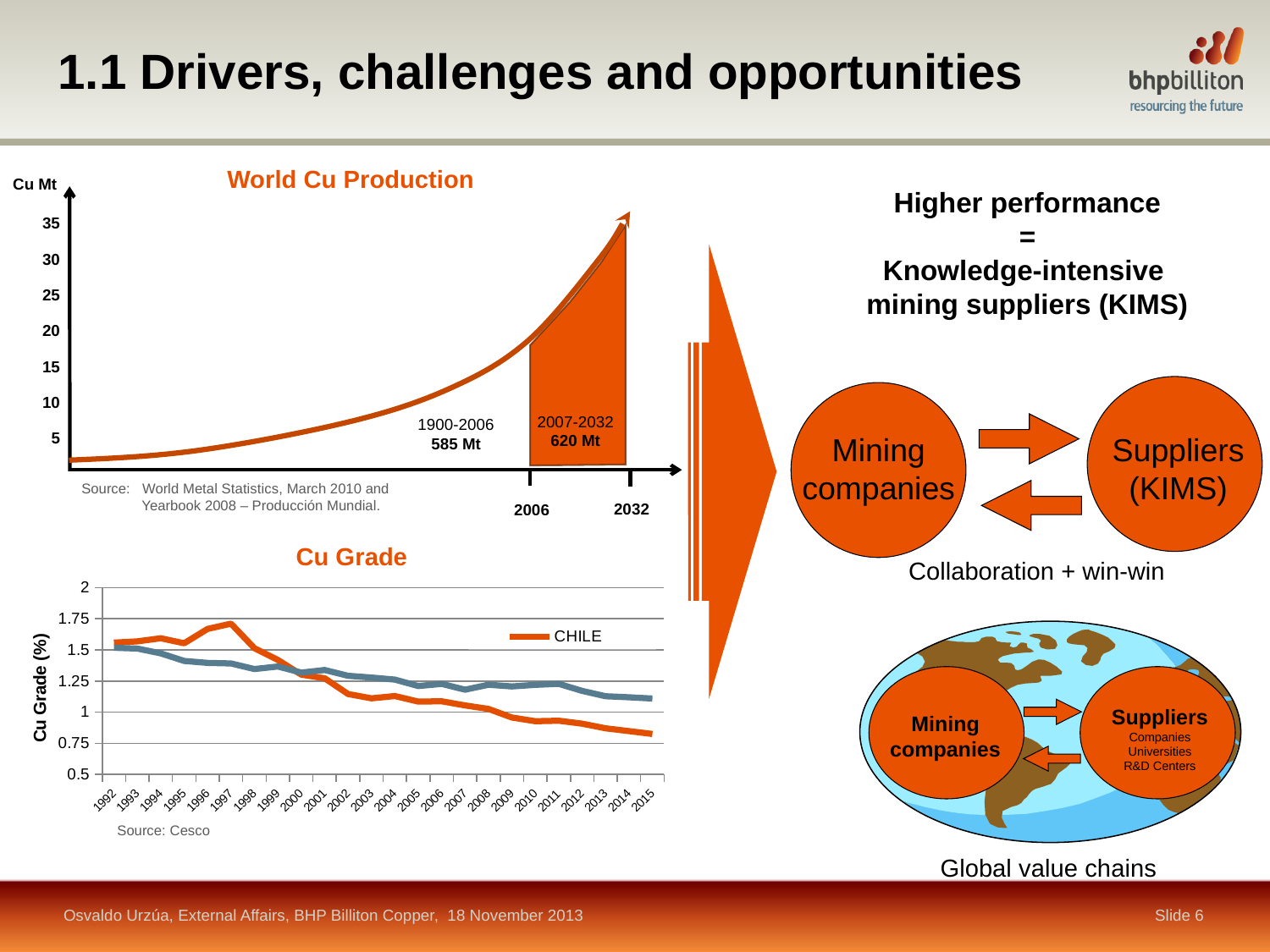
How many series does the legend of the Cu Grade chart list? 1 In the Cu Grade chart, in which year is the CHILE copper grade highest? 1997 How many years are shown on the x axis of the Cu Grade chart? 24 What unit is shown on the vertical axis of the World Cu Production chart? Cu Mt In the World Cu Production chart, what cumulative production is shown for the period 2007-2032? 620 Mt In the Cu Grade chart, is the CHILE value for 2015 greater or less than 1? less In the World Cu Production chart, does world copper production rise or fall over time along the x axis? rise In the Cu Grade chart, does the CHILE copper grade rise or fall from 1992 to 2015? fall In the World Cu Production chart, which period has the larger cumulative production, 1900-2006 or 2007-2032? 2007-2032 In the World Cu Production chart, what is the difference between the 2007-2032 and 1900-2006 cumulative production figures? 35 Mt What kind of chart is the Cu Grade chart? line chart In the World Cu Production chart, what cumulative production is shown for the period 1900-2006? 585 Mt